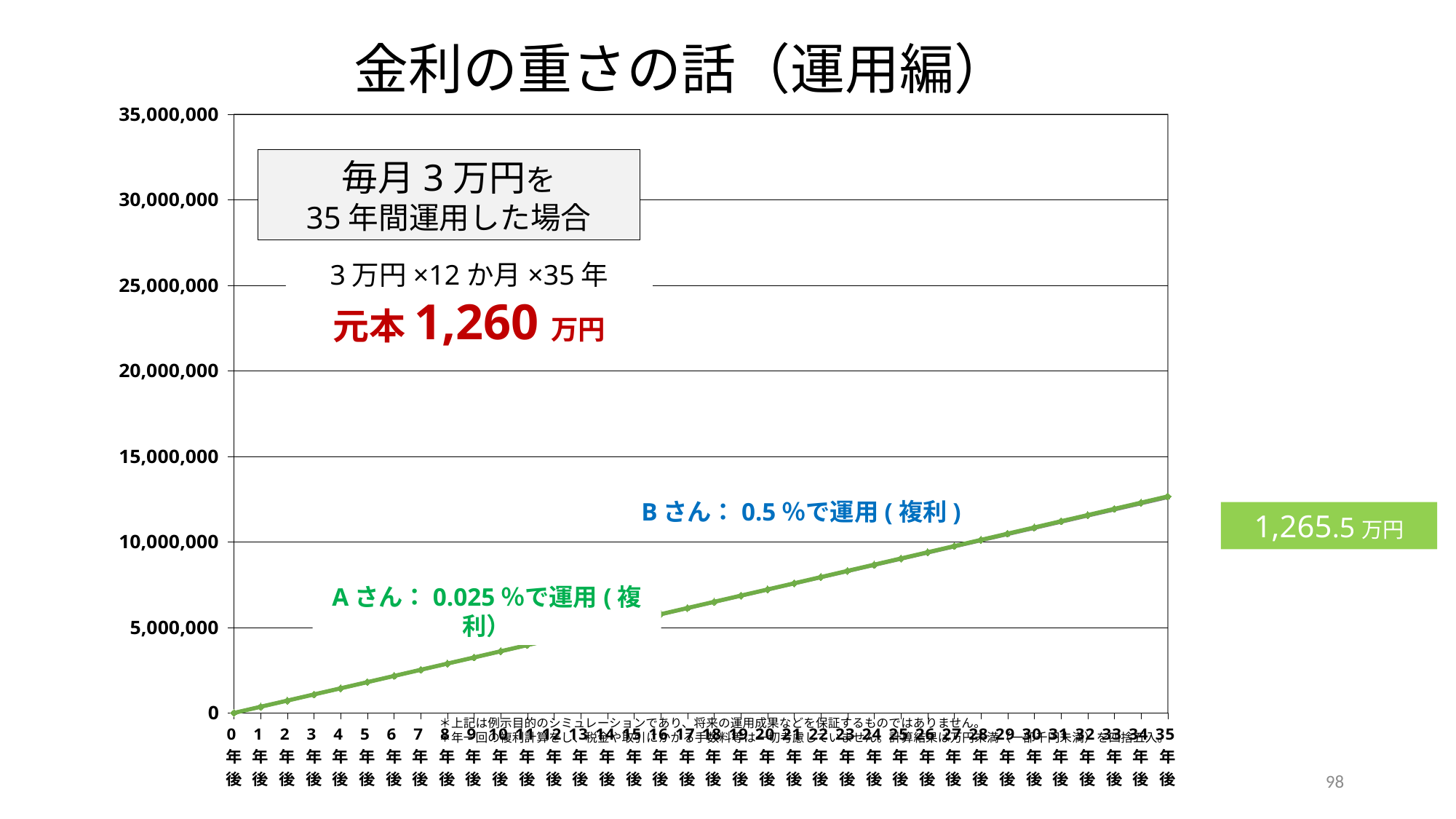
What kind of chart is shown on the slide? line chart Which is larger, the value at 30年後 or the value at 10年後? 30年後 What is the title of the slide containing the chart? 金利の重さの話（運用編） How many points are plotted along the x axis, from 0年後 to 35年後? 36 What is the value of the line at 0年後? 0 Is the value at 20年後 greater or less than 10,000,000? less What is the highest value shown on the y axis? 35,000,000 Is the value at 35年後 greater or less than 10,000,000? greater Does the plotted line rise or fall as the years increase along the x axis? rises What value is printed in the green box at the end of the line? 1,265.5万円 Is the value at 10年後 greater or less than 5,000,000? less At which year is the plotted line at its highest? 35年後